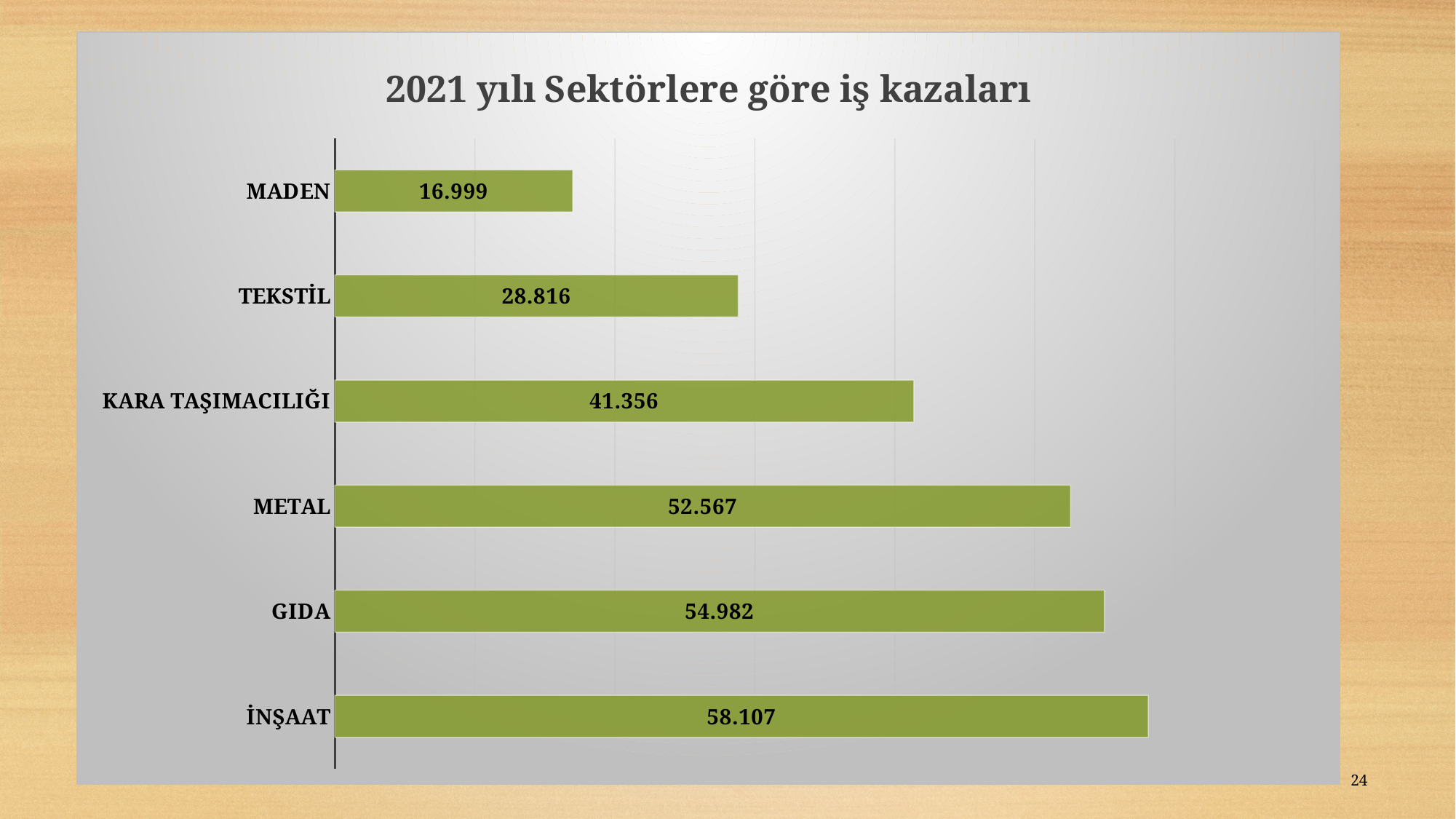
How many sectors are shown in the chart? 6 What is the difference between the values for METAL and KARA TAŞIMACILIĞI? 11.211 What kind of chart is shown on the slide? Bar chart What is the difference between the values for İNŞAAT and GIDA? 3.125 What is the value for GIDA? 54.982 What is the value for MADEN? 16.999 What is the value for TEKSTİL? 28.816 What is the value for KARA TAŞIMACILIĞI? 41.356 Which is larger, the value for METAL or the value for GIDA? GIDA Which sector has the lowest value? MADEN What is the title of the chart? 2021 yılı Sektörlere göre iş kazaları Which sector has the highest value? İNŞAAT